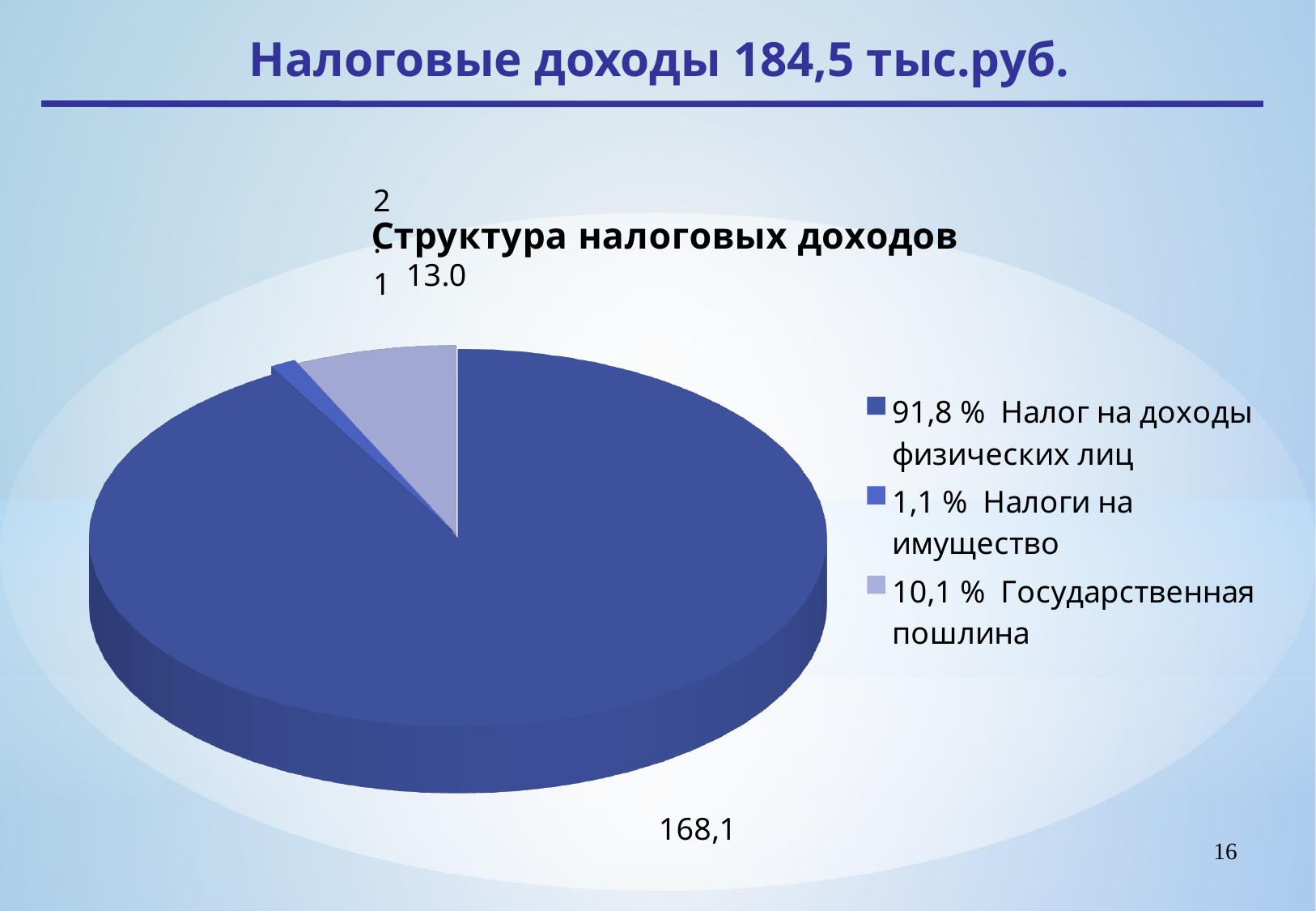
What share of the pie does Государственная пошлина represent according to the legend? 10,1 % What share of the pie does Налог на доходы физических лиц represent according to the legend? 91,8 % Which category has the smallest slice of the pie? Налоги на имущество What share of the pie does Налоги на имущество represent according to the legend? 1,1 % What kind of chart is shown on the slide? pie chart Which is larger: the slice for Государственная пошлина or the slice for Налоги на имущество? Государственная пошлина What value is labelled on the slice for Налог на доходы физических лиц? 168,1 Which category has the largest slice of the pie? Налог на доходы физических лиц What is the difference between the labelled values for Налог на доходы физических лиц and Государственная пошлина? 155,1 How many slices does the pie chart have? 3 What is the title of the pie chart? Структура налоговых доходов What value is labelled on the slice for Государственная пошлина? 13.0